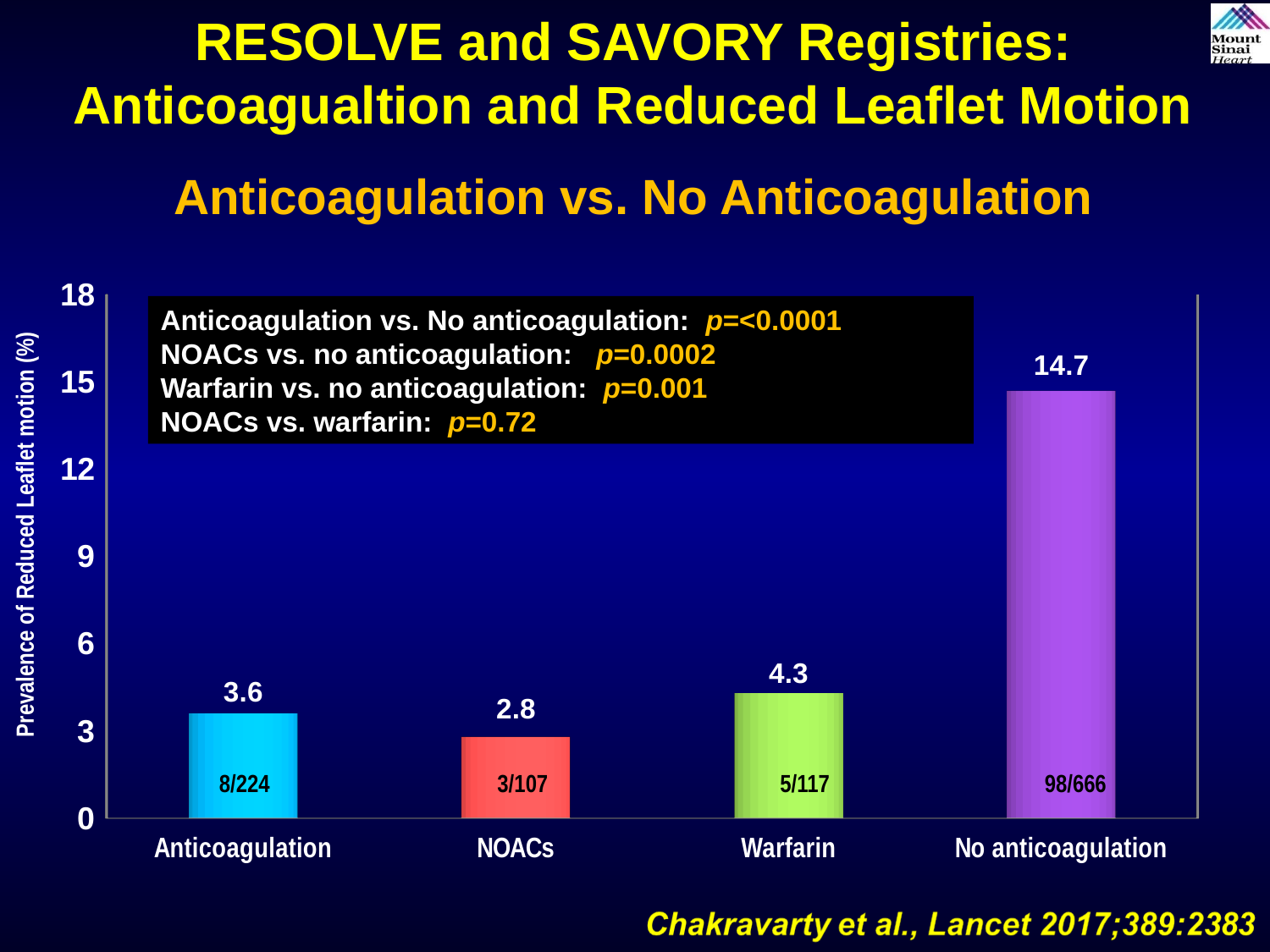
Which group has the lowest prevalence of reduced leaflet motion? NOACs What is the prevalence of reduced leaflet motion for the Warfarin group? 4.3 What fraction is printed inside the No anticoagulation bar? 98/666 What is the difference in prevalence between the Warfarin and NOACs groups? 1.5 What is the prevalence of reduced leaflet motion for the NOACs group? 2.8 Which has a higher prevalence of reduced leaflet motion, Warfarin or NOACs? Warfarin What is the prevalence of reduced leaflet motion for the No anticoagulation group? 14.7 What is the difference in prevalence between the No anticoagulation and Anticoagulation groups? 11.1 What kind of chart is shown on the slide? Bar chart How many groups are shown on the x axis of the chart? 4 What is the prevalence of reduced leaflet motion for the Anticoagulation group? 3.6 Which group has the highest prevalence of reduced leaflet motion? No anticoagulation